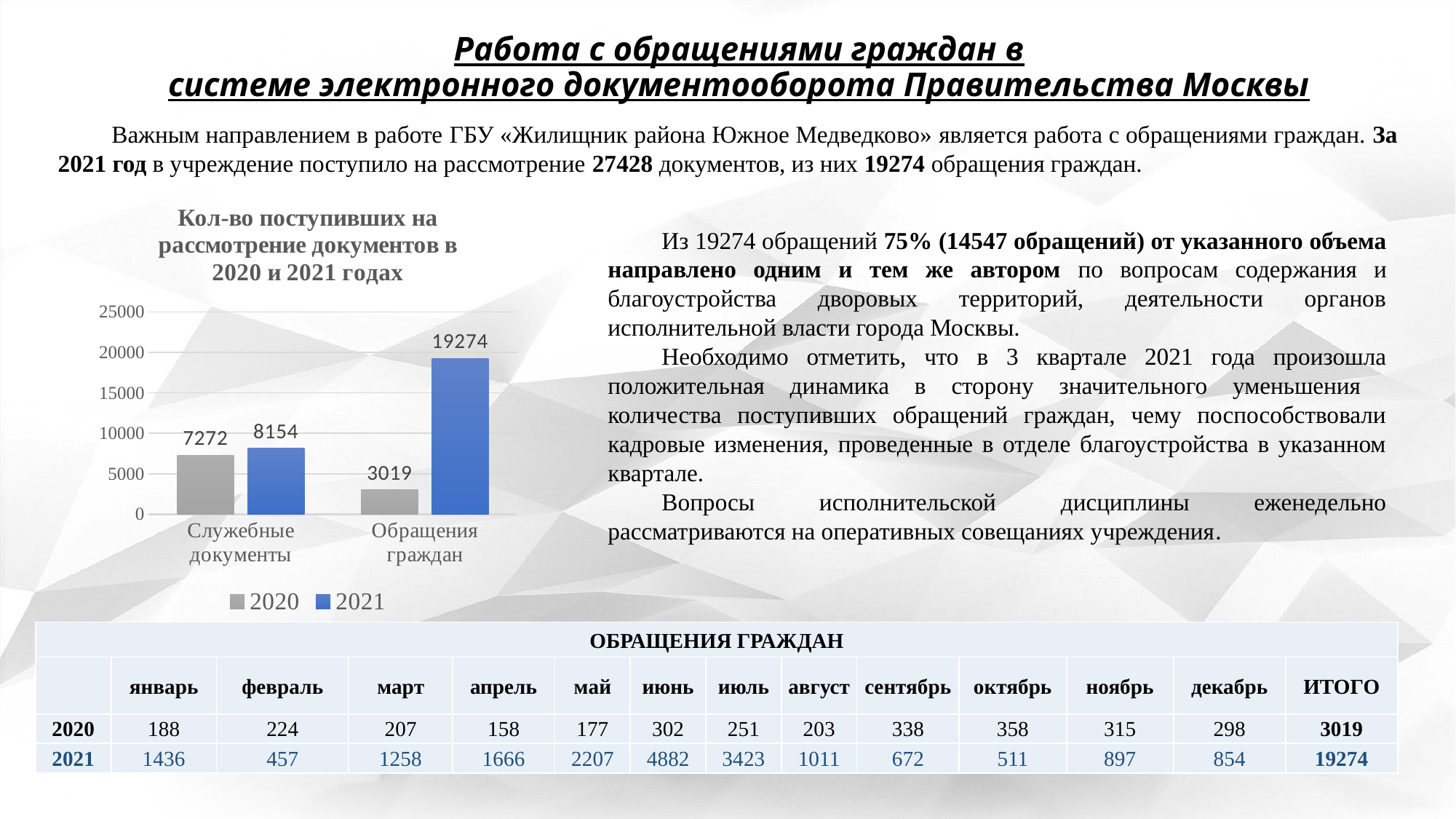
Which is larger: Служебные документы in 2021 or Обращения граждан in 2020? Служебные документы in 2021 What is the difference between the 2021 and 2020 values for Служебные документы? 882 Which bar has the highest value in the chart? Обращения граждан, 2021 What type of chart is shown on the slide? bar chart How many categories are shown on the x axis of the chart? 2 What is the value for Служебные документы in 2021? 8154 How many series does the legend list? 2 What is the value for Служебные документы in 2020? 7272 What is the value for Обращения граждан in 2021? 19274 Which bar has the lowest value in the chart? Обращения граждан, 2020 What is the difference between the 2021 and 2020 values for Обращения граждан? 16255 What is the value for Обращения граждан in 2020? 3019